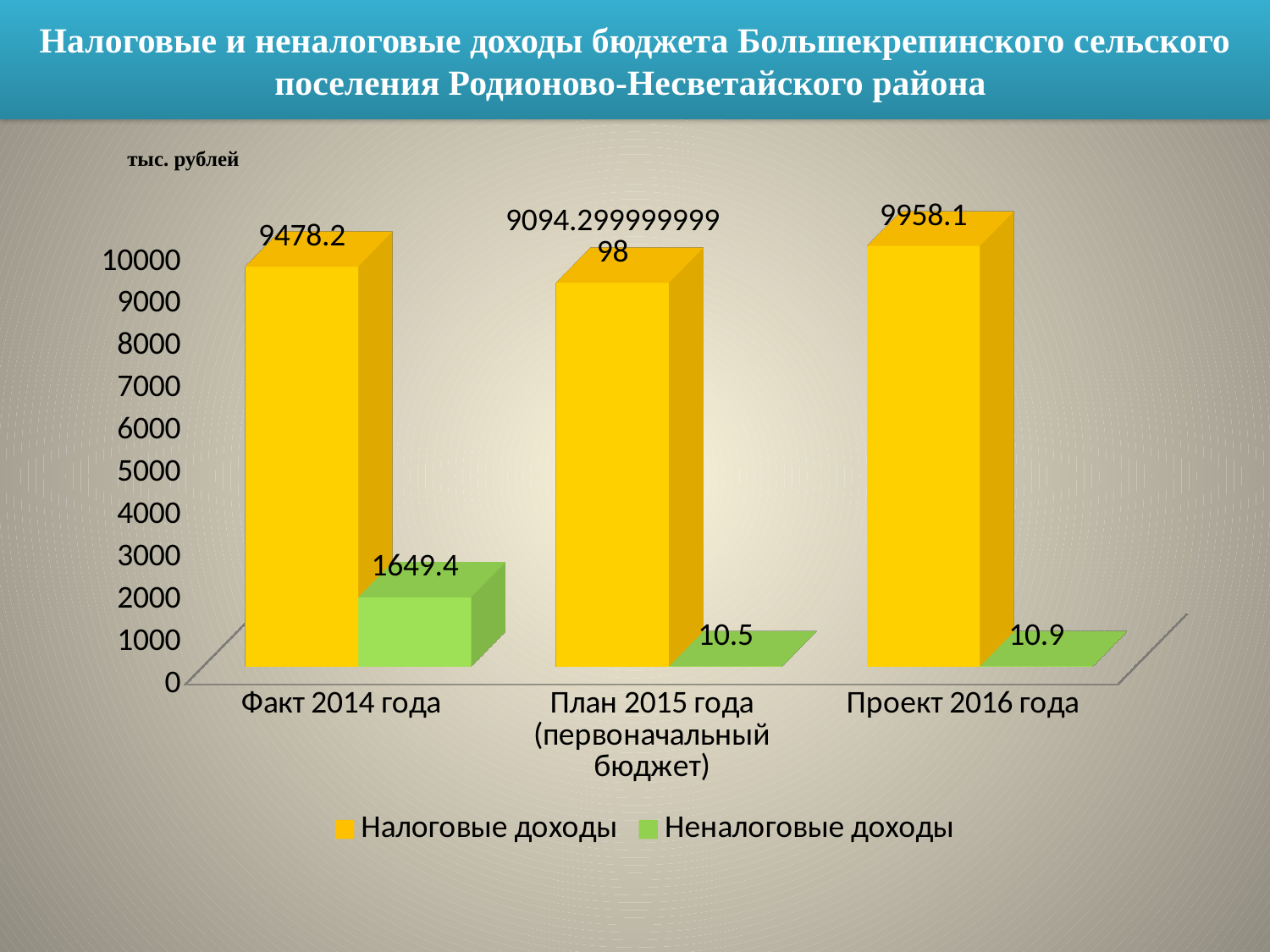
What is the value of Неналоговые доходы for Факт 2014 года? 1649.4 Which category has the lowest value of Неналоговые доходы? План 2015 года (первоначальный бюджет) Is the value of Неналоговые доходы for Факт 2014 года greater or less than 2000? less What is the value of Неналоговые доходы for План 2015 года (первоначальный бюджет)? 10.5 How many series does the legend list? 2 What is the value of Налоговые доходы for Проект 2016 года? 9958.1 What is the difference between Налоговые доходы for Проект 2016 года and Факт 2014 года? 479.9 What is the difference between Неналоговые доходы for Проект 2016 года and План 2015 года? 0.4 What kind of chart is shown on the slide? bar chart Which is larger: Налоговые доходы for Факт 2014 года or for План 2015 года (первоначальный бюджет)? Факт 2014 года What is the value of Налоговые доходы for Факт 2014 года? 9478.2 Which category has the highest value of Налоговые доходы? Проект 2016 года